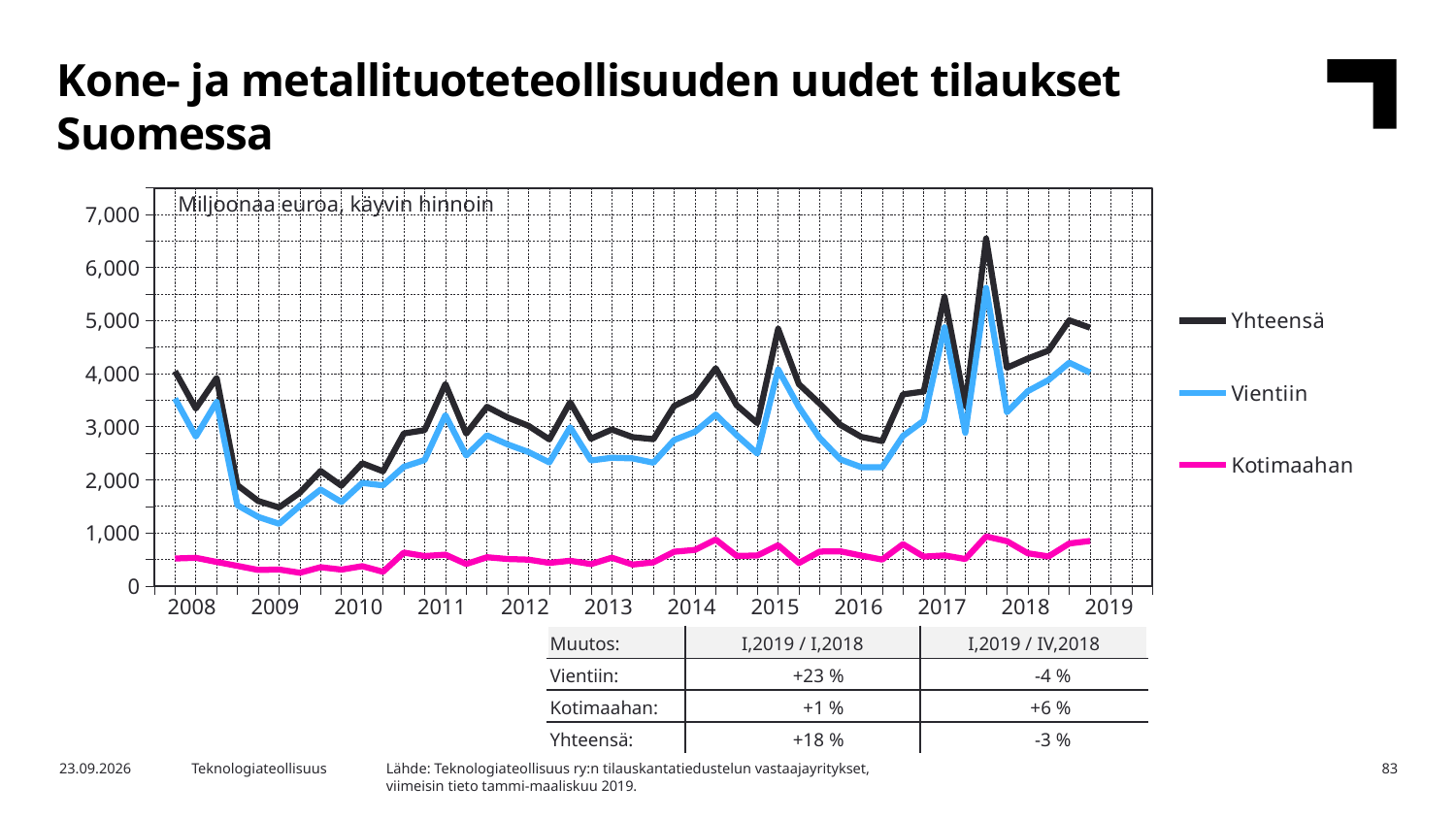
How many series does the chart legend list? 3 Is the Yhteensä value at the start of 2008 greater or less than 3,000? greater What kind of chart is shown on the slide? line chart Is the value of the Vientiin series at the start of 2009 greater or less than 2,000? less Is the peak value of the Yhteensä series in 2017 greater or less than 6,000? greater What is the highest value shown on the vertical axis of the chart? 7,000 Which series is larger at the start of 2008, Vientiin or Kotimaahan? Vientiin Which series has the highest values throughout the chart? Yhteensä What are the three series named in the chart legend? Yhteensä, Vientiin, Kotimaahan Which series has the lowest values throughout the chart? Kotimaahan What unit is stated in the label at the top of the chart? Miljoonaa euroa, käyvin hinnoin